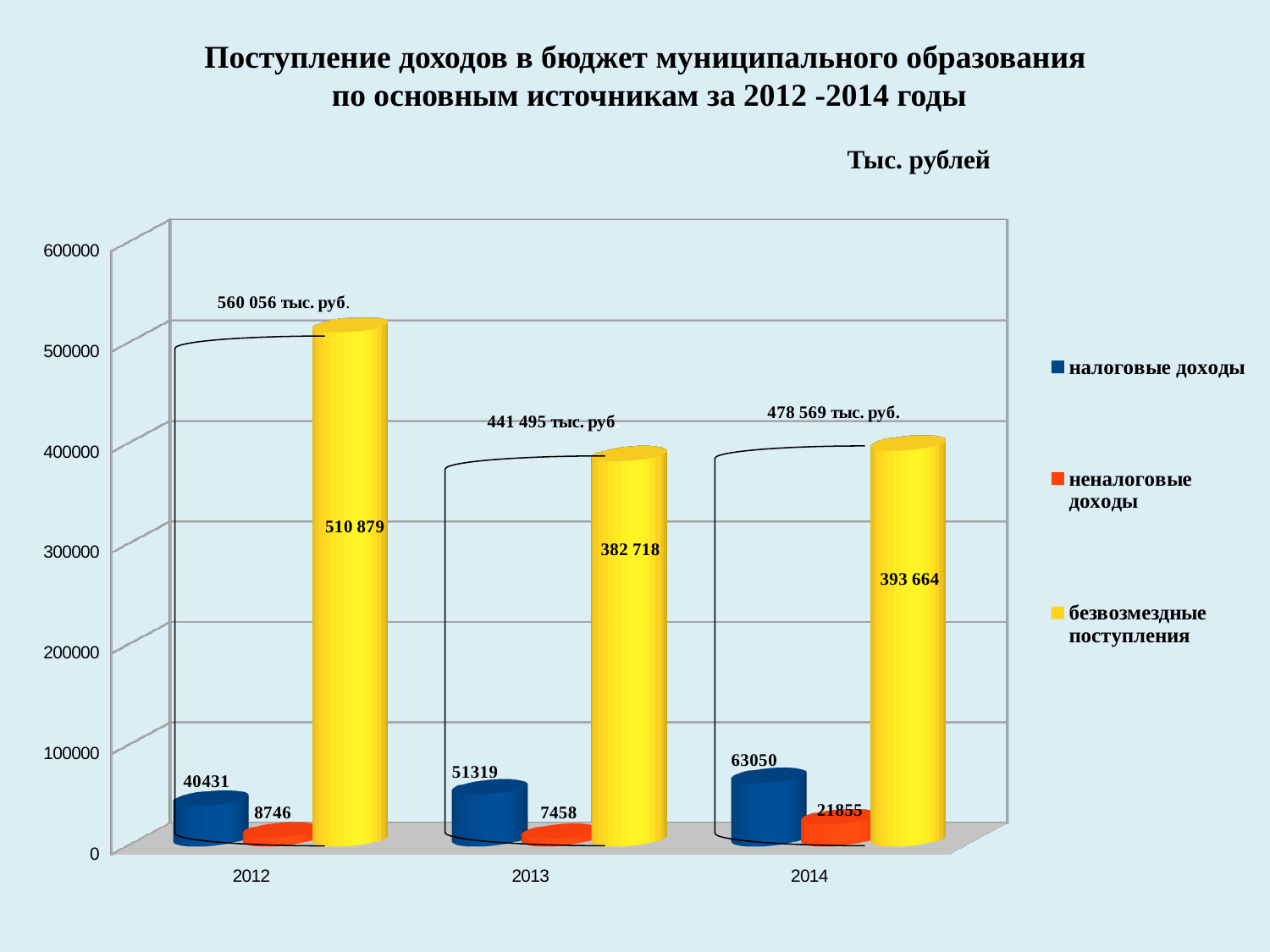
How many series does the legend list? 3 What is the value for безвозмездные поступления in 2013? 382 718 In which year is безвозмездные поступления highest? 2012 What kind of chart is shown on the slide? bar chart In which year is неналоговые доходы lowest? 2013 What total is annotated above the 2014 group of bars? 478 569 тыс. руб. What is the difference between налоговые доходы in 2014 and in 2013? 11731 What is the value for неналоговые доходы in 2014? 21855 Is the value for безвозмездные поступления in 2012 greater or less than 500000? greater How many years are shown on the x axis? 3 Which is larger: безвозмездные поступления in 2013 or in 2014? 2014 What is the value for налоговые доходы in 2012? 40431